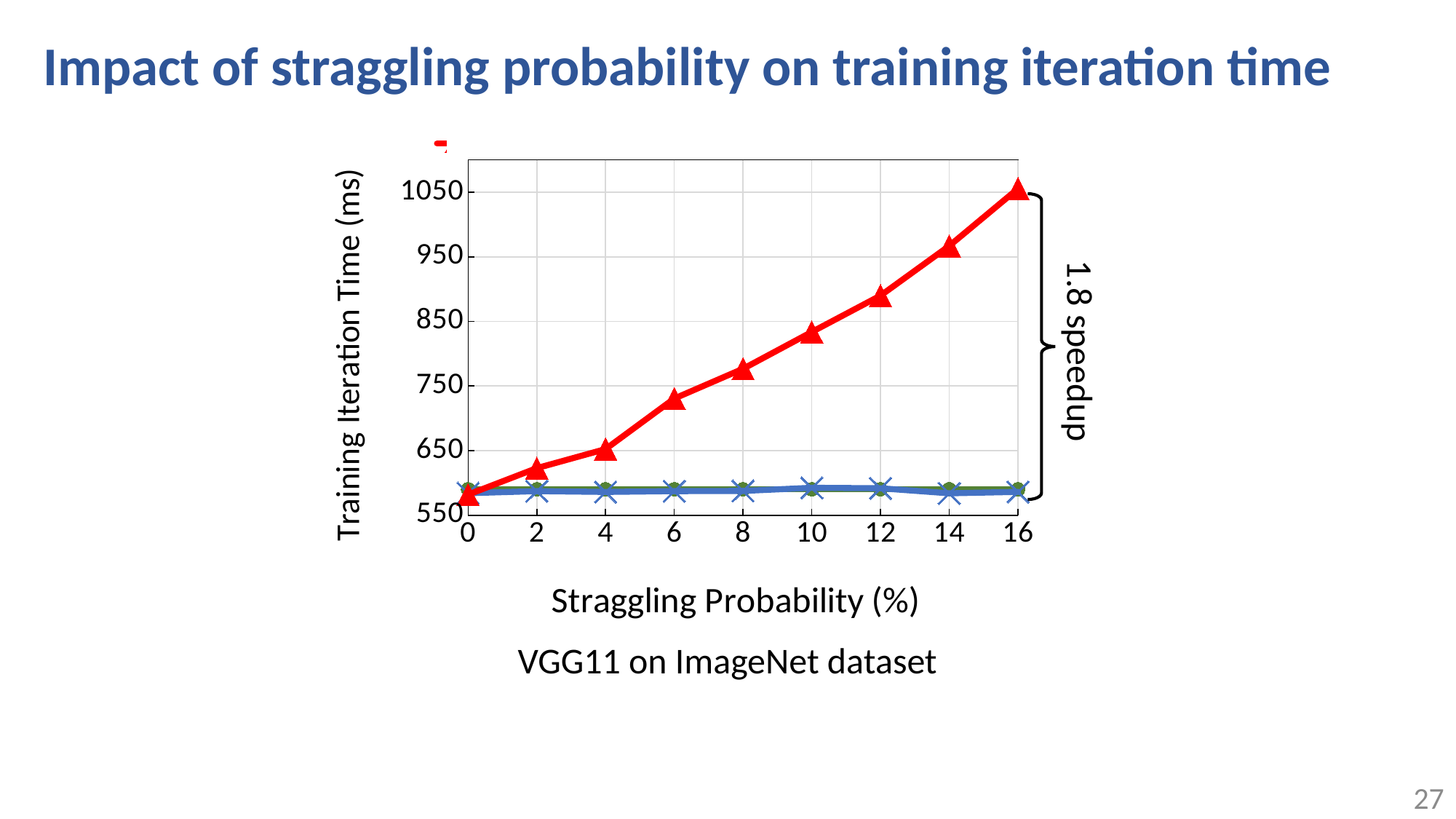
At a straggling probability of 10%, is the value of the red triangle-marker line greater or less than 750? greater Does the red line with triangle markers rise or fall as straggling probability increases from 0 to 16? rise At a straggling probability of 16%, which line has the larger value, the red triangle-marker line or the blue X-marker line? the red triangle-marker line At which straggling probability does the red triangle-marker line have its lowest value? 0 How many straggling probability values are plotted along the x axis? 9 At a straggling probability of 12%, is the value of the red triangle-marker line greater or less than 850? greater At a straggling probability of 4%, is the value of the red triangle-marker line greater or less than 750? less What is the x-axis title of the chart? Straggling Probability (%) At which straggling probability does the red triangle-marker line reach its highest value? 16 What kind of chart is shown on the slide? line chart